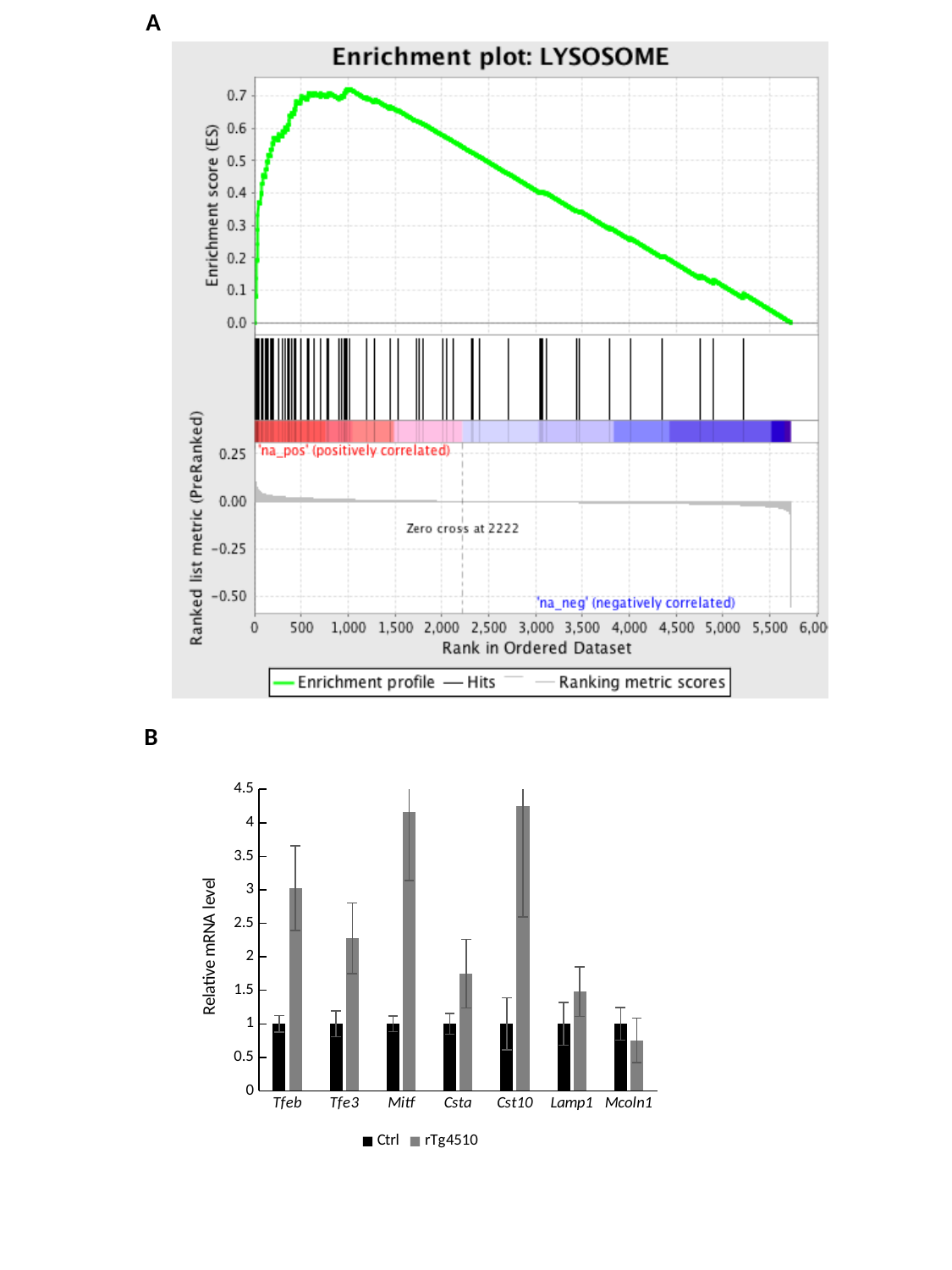
In chart B, which is larger: the rTg4510 value for Tfeb or the rTg4510 value for Tfe3? Tfeb In chart B, how many series does the legend list? 2 In chart B, which gene has the lowest rTg4510 relative mRNA level? Mcoln1 What is the title of chart A (the upper chart)? Enrichment plot: LYSOSOME In chart B, is the rTg4510 value for Mitf greater or less than 3.5? greater In chart B, for Mcoln1, which series has the larger value: Ctrl or rTg4510? Ctrl In chart B, is the rTg4510 value for Tfeb greater or less than 2.5? greater In chart B, how many genes are shown on the x axis? 7 In chart B, is the rTg4510 value for Csta greater or less than 2? less In chart A, at what rank does the zero cross occur? 2222 What kind of chart is chart B (the lower chart)? bar chart In chart A, how many entries does the legend list? 3